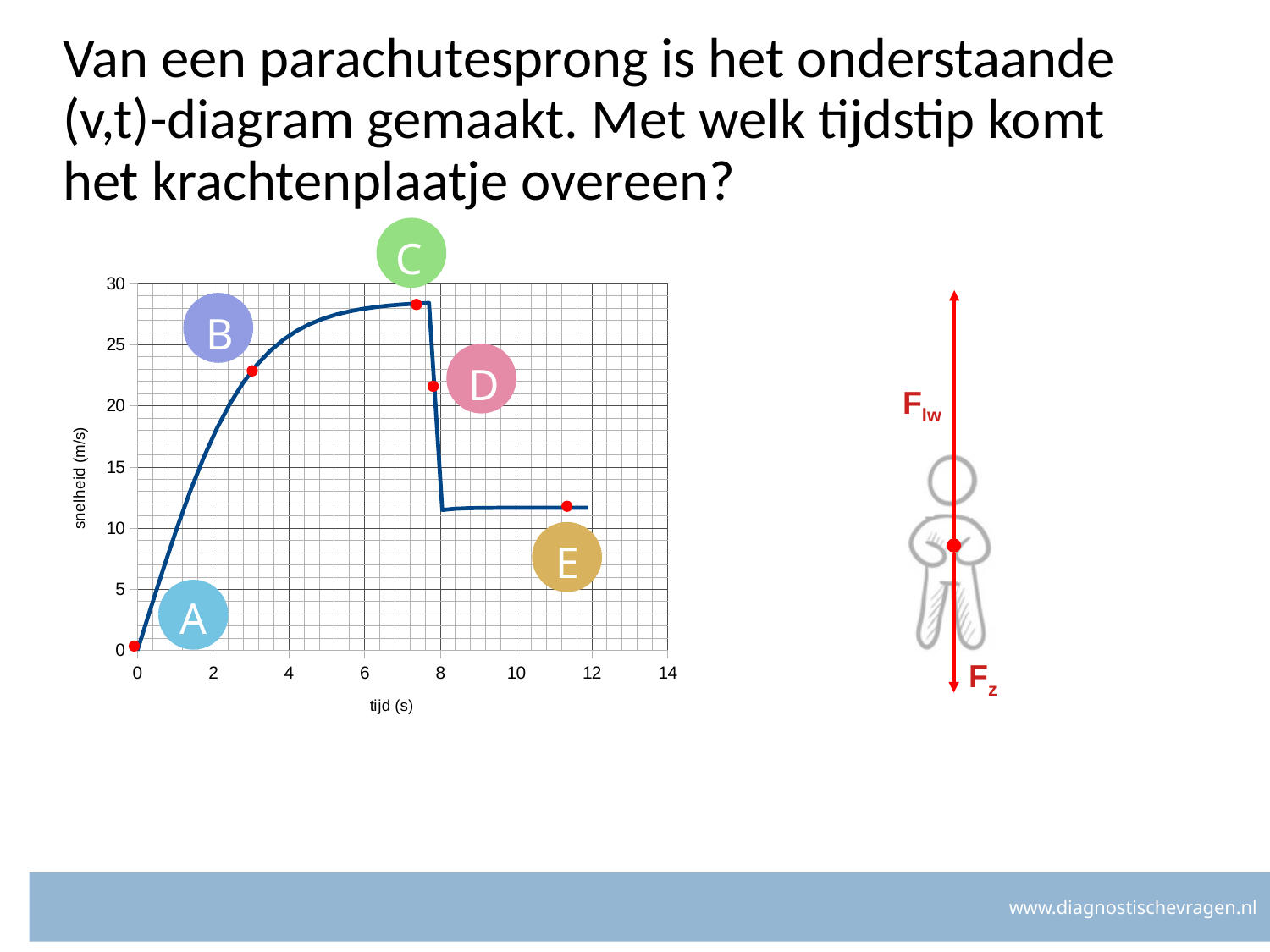
Is the speed at point B greater or less than 20 m/s? greater Is the speed at point C greater or less than 25 m/s? greater What is the label of the vertical axis of the chart? snelheid (m/s) Which labelled point has the lowest speed? A Which point has a higher speed, D or E? D What is the speed at point A? 0 m/s How many labelled points (A to E) are marked on the curve? 5 What is the label of the horizontal axis of the chart? tijd (s) Which labelled point has the highest speed? C Is the speed at point E greater or less than 15 m/s? less Does the speed rise or fall between point A and point C? rise What kind of chart is shown on the slide? line chart